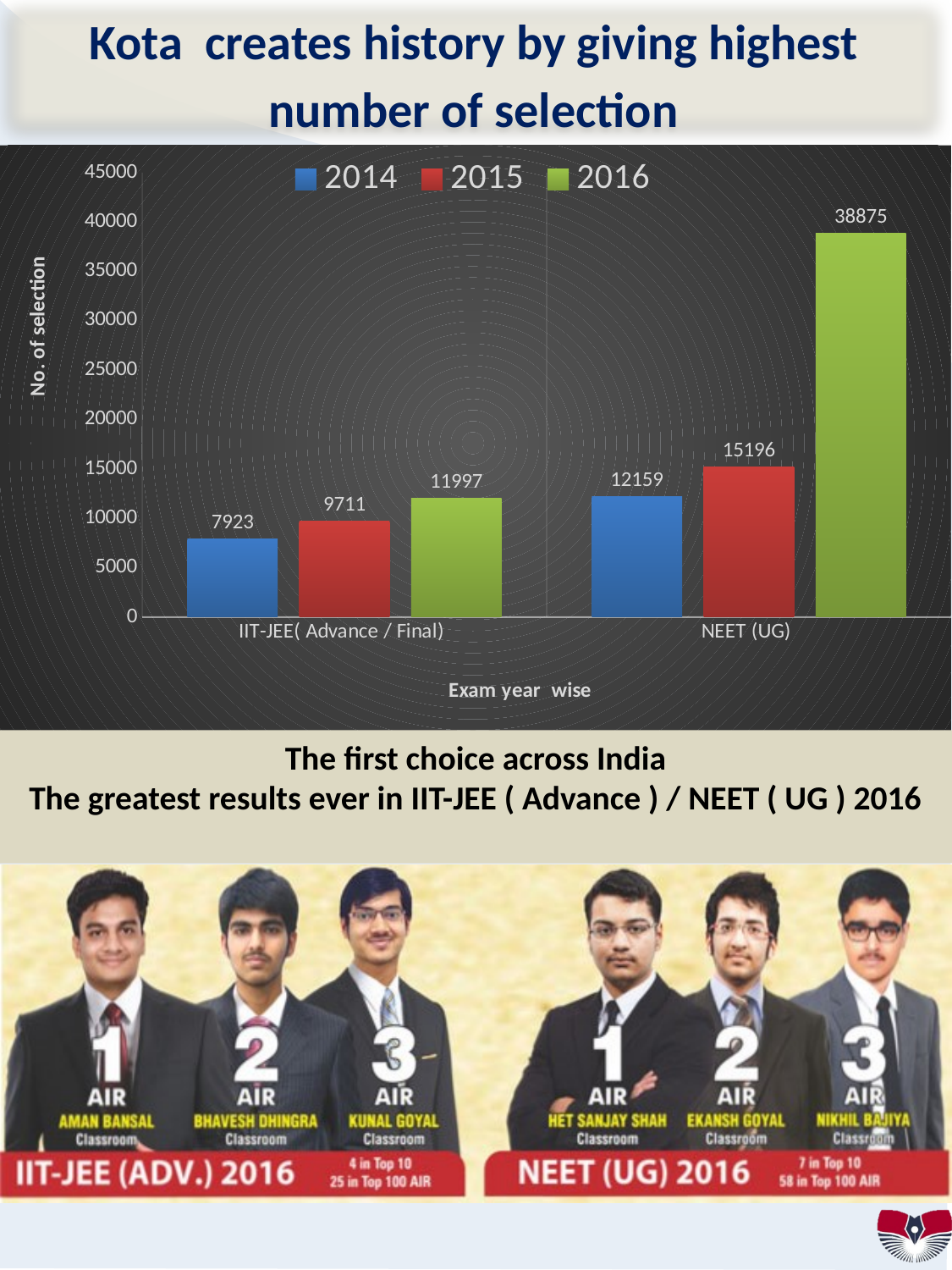
How many series does the legend list? 3 What is the number of selections for NEET (UG) in 2016? 38875 What is the number of selections for IIT-JEE( Advance / Final) in 2016? 11997 What is the difference between the 2015 and 2014 selections for IIT-JEE( Advance / Final)? 1788 Which exam and year has the highest number of selections? NEET (UG) in 2016 Do the selections for NEET (UG) rise or fall from 2014 to 2016? Rise What is the number of selections for IIT-JEE( Advance / Final) in 2014? 7923 What is the number of selections for NEET (UG) in 2015? 15196 What is the difference between the 2016 and 2015 selections for NEET (UG)? 23679 What kind of chart is shown on the slide? Bar chart Which is larger: the 2016 value for IIT-JEE( Advance / Final) or the 2014 value for NEET (UG)? 2014 value for NEET (UG) Which exam and year has the lowest number of selections? IIT-JEE( Advance / Final) in 2014